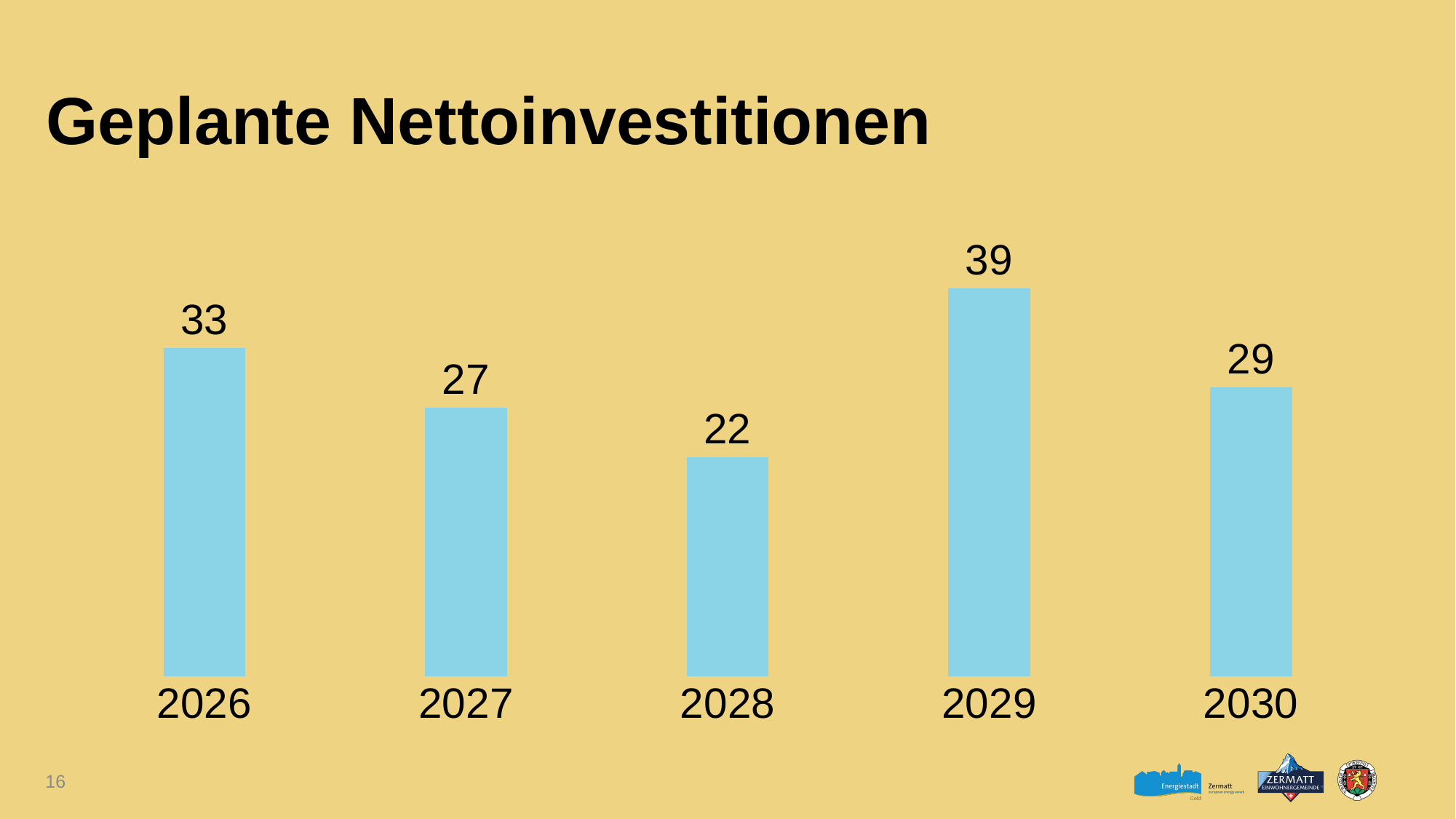
What is the difference between the values for 2026 and 2027? 6 Which year has the highest value? 2029 What is the value for 2030? 29 What is the value for 2026? 33 What is the value for 2028? 22 How many years are shown in the chart? 5 What is the title of the slide? Geplante Nettoinvestitionen Which year has the lowest value? 2028 What kind of chart is shown on the slide? bar chart What is the difference between the values for 2029 and 2028? 17 Which is larger, the value for 2027 or the value for 2030? 2030 Do the values rise or fall from 2026 to 2028? fall